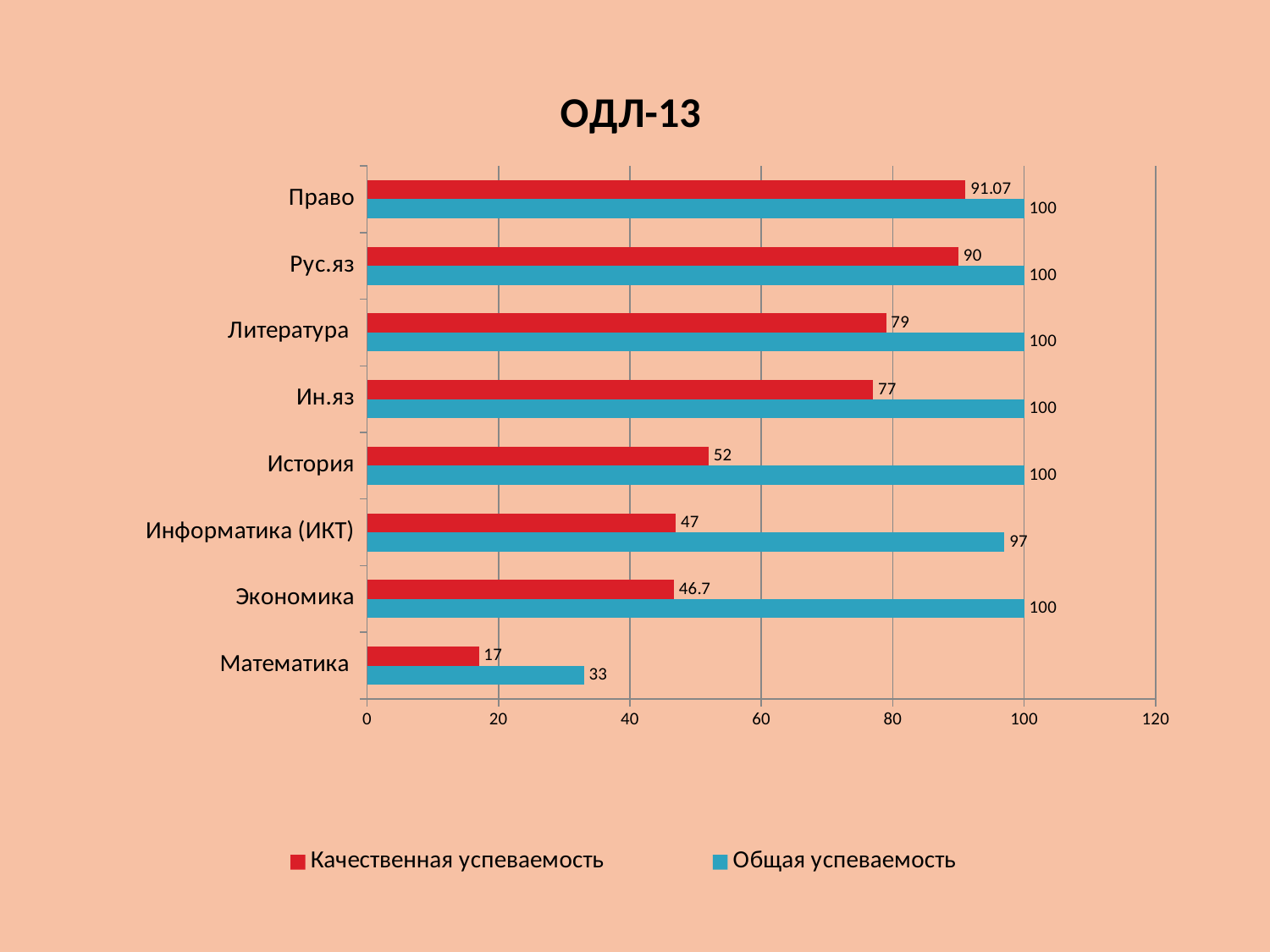
How many categories are shown on the chart? 8 What is the difference between the Общая успеваемость and Качественная успеваемость values for Математика? 16 What is the title of the chart? ОДЛ-13 What is the Общая успеваемость value for Информатика (ИКТ)? 97 How many series does the legend list? 2 Which category has the lowest Качественная успеваемость value? Математика Which is larger, the Качественная успеваемость value for Ин.яз or for Информатика (ИКТ)? Ин.яз What is the Качественная успеваемость value for Экономика? 46.7 What kind of chart is shown on the slide? Bar chart What is the difference between the Качественная успеваемость values for Литература and История? 27 What is the Качественная успеваемость value for Право? 91.07 Which category has the highest Качественная успеваемость value? Право